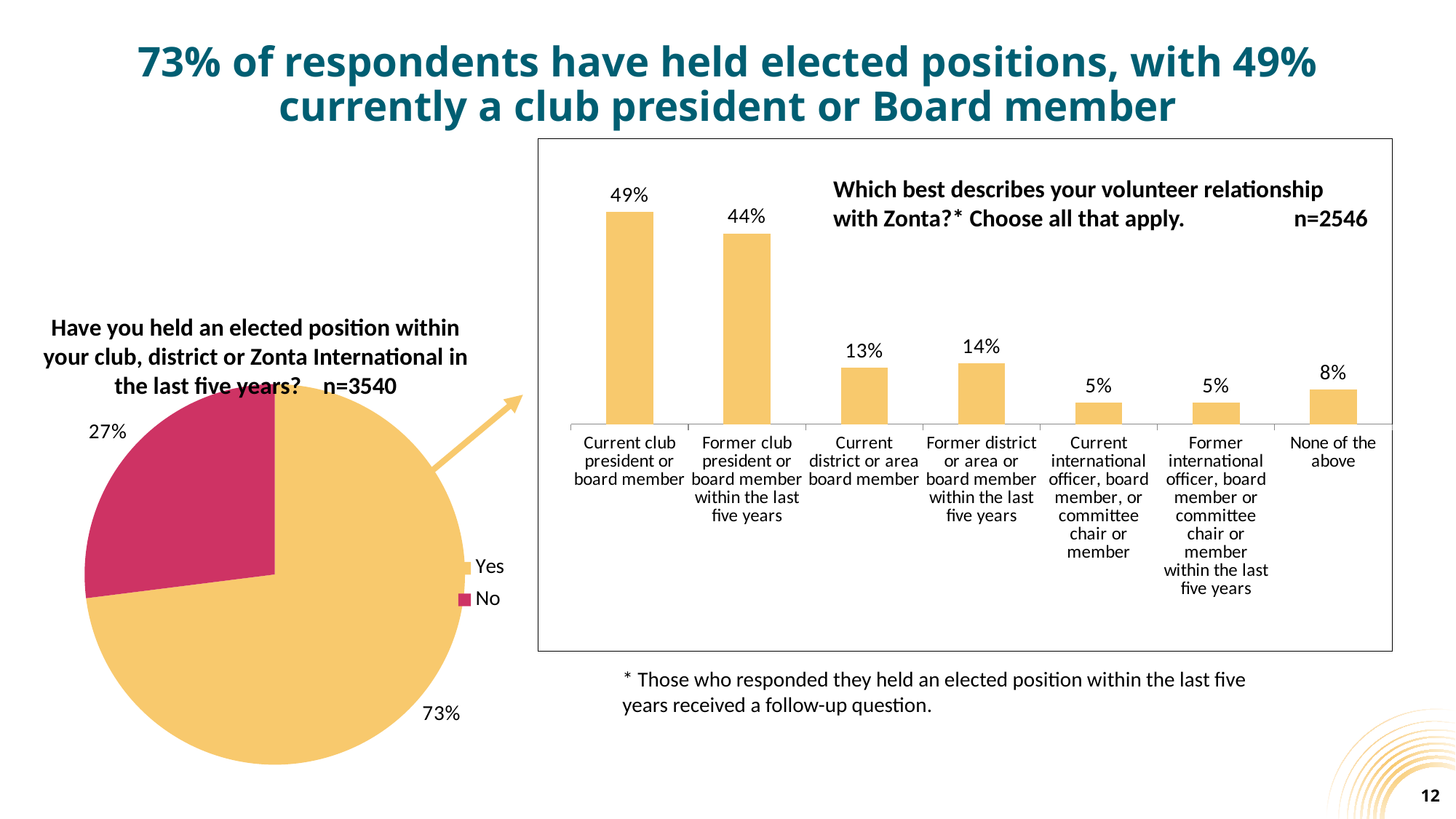
In the bar chart on the right, what is the value for Current club president or board member? 49% In the pie chart on the left, what percentage of respondents answered No? 27% In the pie chart on the left, how many slices are there? 2 In the pie chart on the left, what percentage of respondents answered Yes? 73% What kind of chart is the chart on the left? Pie chart In the bar chart on the right, what is the value for None of the above? 8% In the bar chart on the right, how many categories are shown? 7 What is the sample size (n) shown for the bar chart on the right? n=2546 In the pie chart on the left, what is the difference between the Yes and No shares? 46% In the bar chart on the right, which is larger: Former district or area board member within the last five years or Current district or area board member? Former district or area board member within the last five years In the bar chart on the right, which category has the highest value? Current club president or board member In the bar chart on the right, what is the difference between Former club president or board member within the last five years and Current district or area board member? 31%